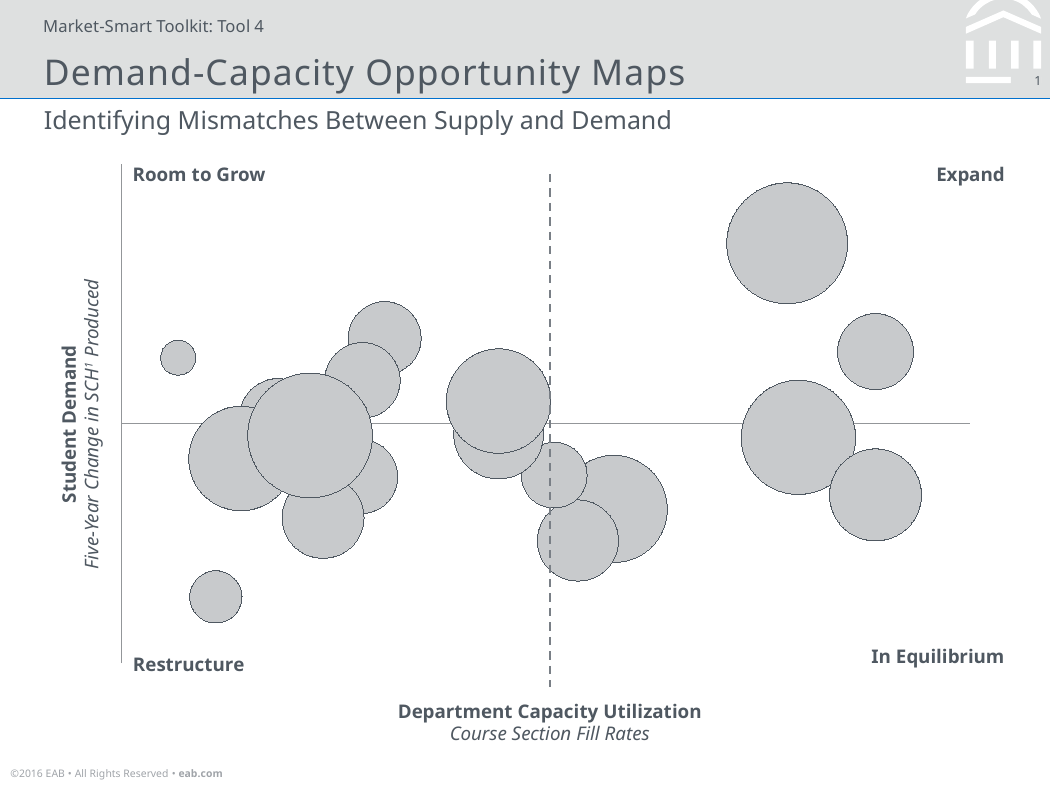
What is the label of the horizontal axis of the chart? Department Capacity Utilization Are there more bubbles to the left or to the right of the dashed vertical line? left Which quadrant label appears in the top-right corner of the chart? Expand What kind of chart is shown on the slide? Bubble chart